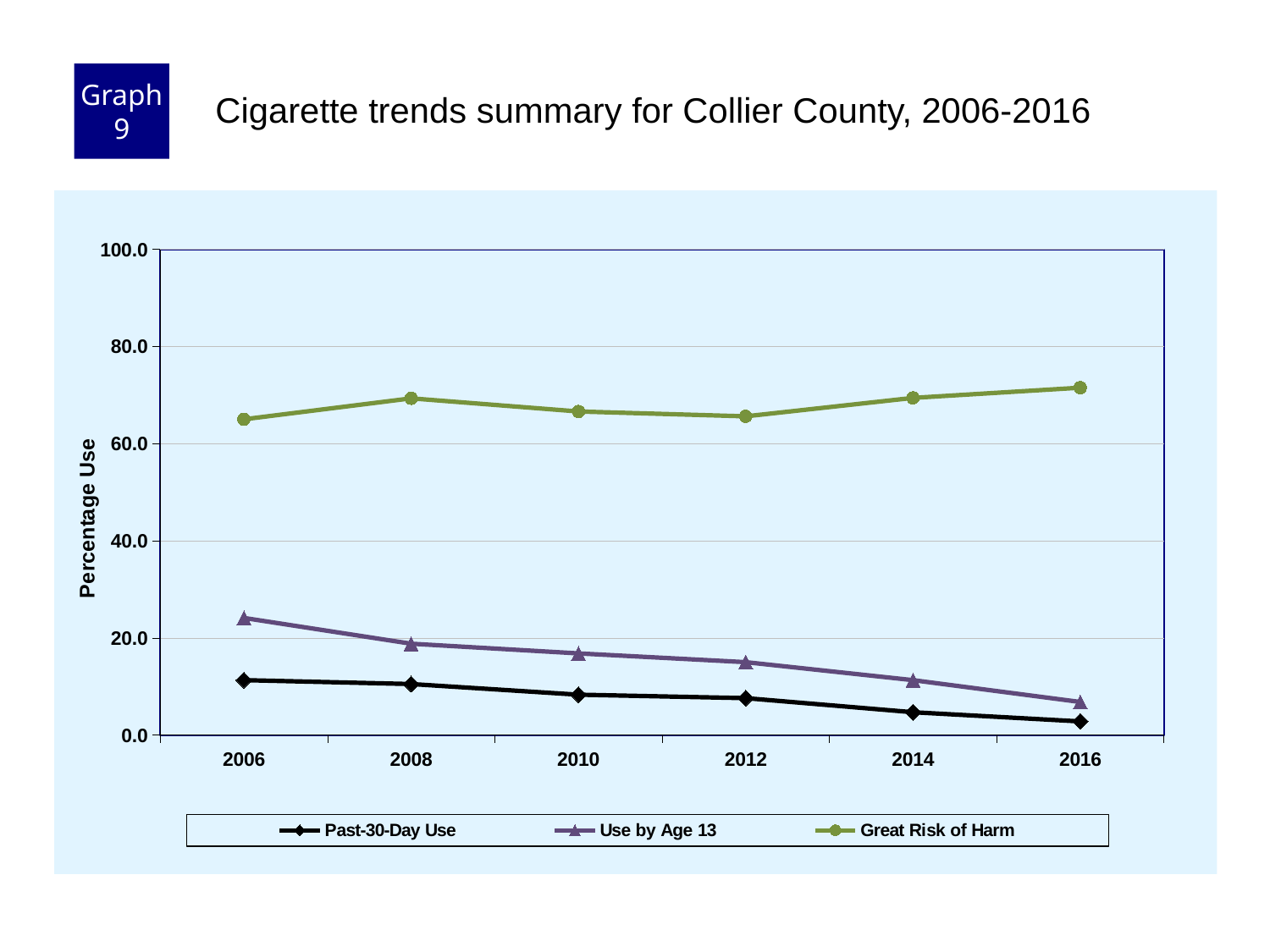
In which year is the Past-30-Day Use value lowest? 2016 In 2006, which is larger: Past-30-Day Use or Use by Age 13? Use by Age 13 What kind of chart is shown on the slide? line chart Does the Past-30-Day Use series rise or fall from 2006 to 2016? fall What is the label on the y axis? Percentage Use Is the Great Risk of Harm value for 2006 greater or less than 60.0? greater In which year is the Great Risk of Harm value highest? 2016 How many years are plotted along the x axis? 6 Is the Use by Age 13 value for 2008 greater or less than 20.0? less Does the Use by Age 13 series rise or fall from 2006 to 2016? fall In which year is the Use by Age 13 value highest? 2006 How many series does the legend list? 3